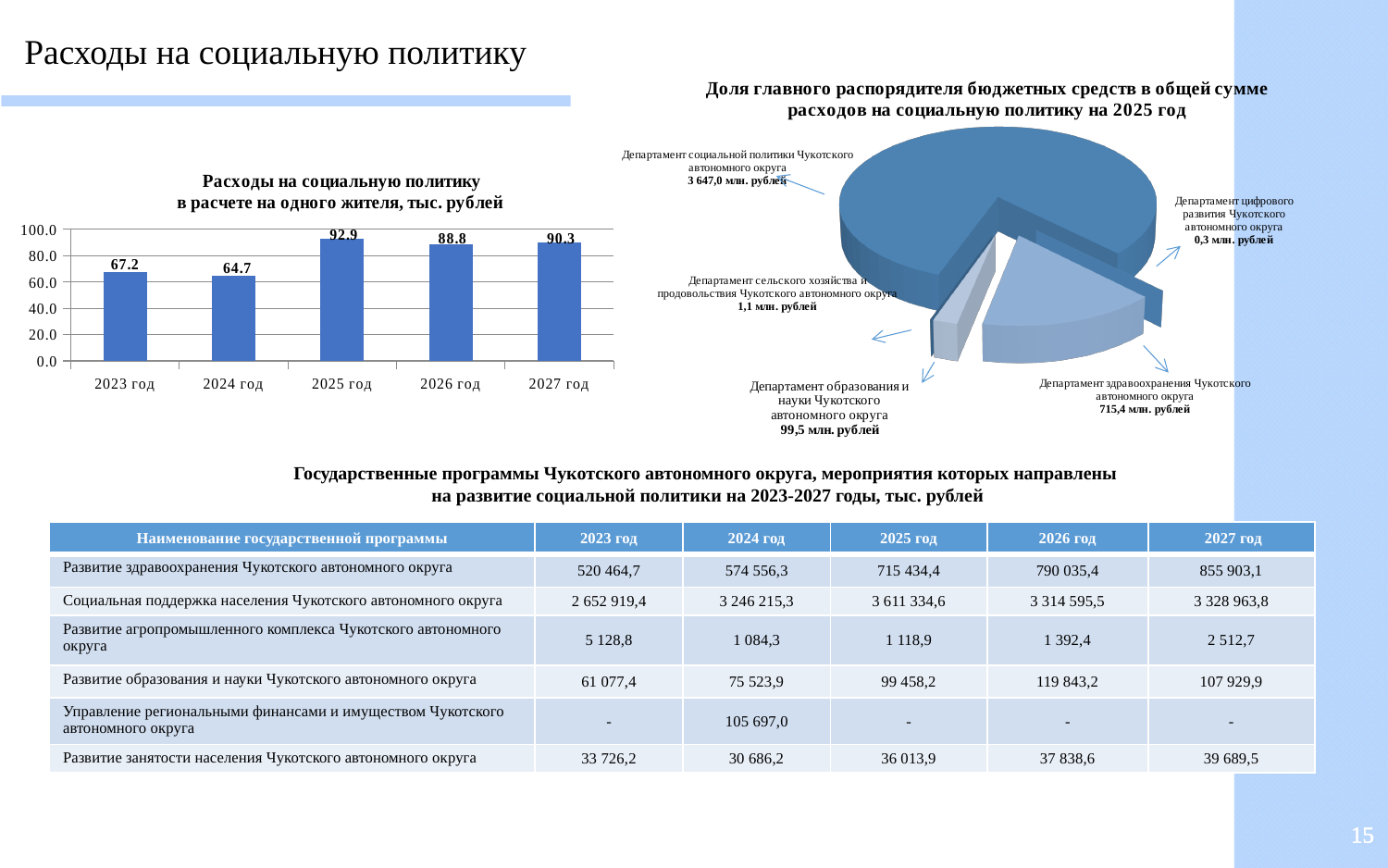
How many years are shown in the bar chart 'Расходы на социальную политику в расчете на одного жителя, тыс. рублей'? 5 In the pie chart 'Доля главного распорядителя бюджетных средств в общей сумме расходов на социальную политику на 2025 год', which department has the smallest value? Департамент цифрового развития Чукотского автономного округа In the bar chart 'Расходы на социальную политику в расчете на одного жителя, тыс. рублей', which year has the highest value? 2025 год How many departments are shown in the pie chart 'Доля главного распорядителя бюджетных средств в общей сумме расходов на социальную политику на 2025 год'? 5 In the bar chart 'Расходы на социальную политику в расчете на одного жителя, тыс. рублей', which year has the lowest value? 2024 год In the pie chart 'Доля главного распорядителя бюджетных средств в общей сумме расходов на социальную политику на 2025 год', what is the value for Департамент здравоохранения Чукотского автономного округа? 715,4 млн. рублей In the bar chart 'Расходы на социальную политику в расчете на одного жителя, тыс. рублей', which is larger: the value for 2027 год or 2026 год? 2027 год In the bar chart 'Расходы на социальную политику в расчете на одного жителя, тыс. рублей', what is the value for 2026 год? 88.8 In the bar chart 'Расходы на социальную политику в расчете на одного жителя, тыс. рублей', what is the difference between the values for 2025 год and 2024 год? 28.2 What type of chart is 'Расходы на социальную политику в расчете на одного жителя, тыс. рублей'? bar chart In the bar chart 'Расходы на социальную политику в расчете на одного жителя, тыс. рублей', what is the value for 2023 год? 67.2 In the pie chart 'Доля главного распорядителя бюджетных средств в общей сумме расходов на социальную политику на 2025 год', which department has the largest value? Департамент социальной политики Чукотского автономного округа